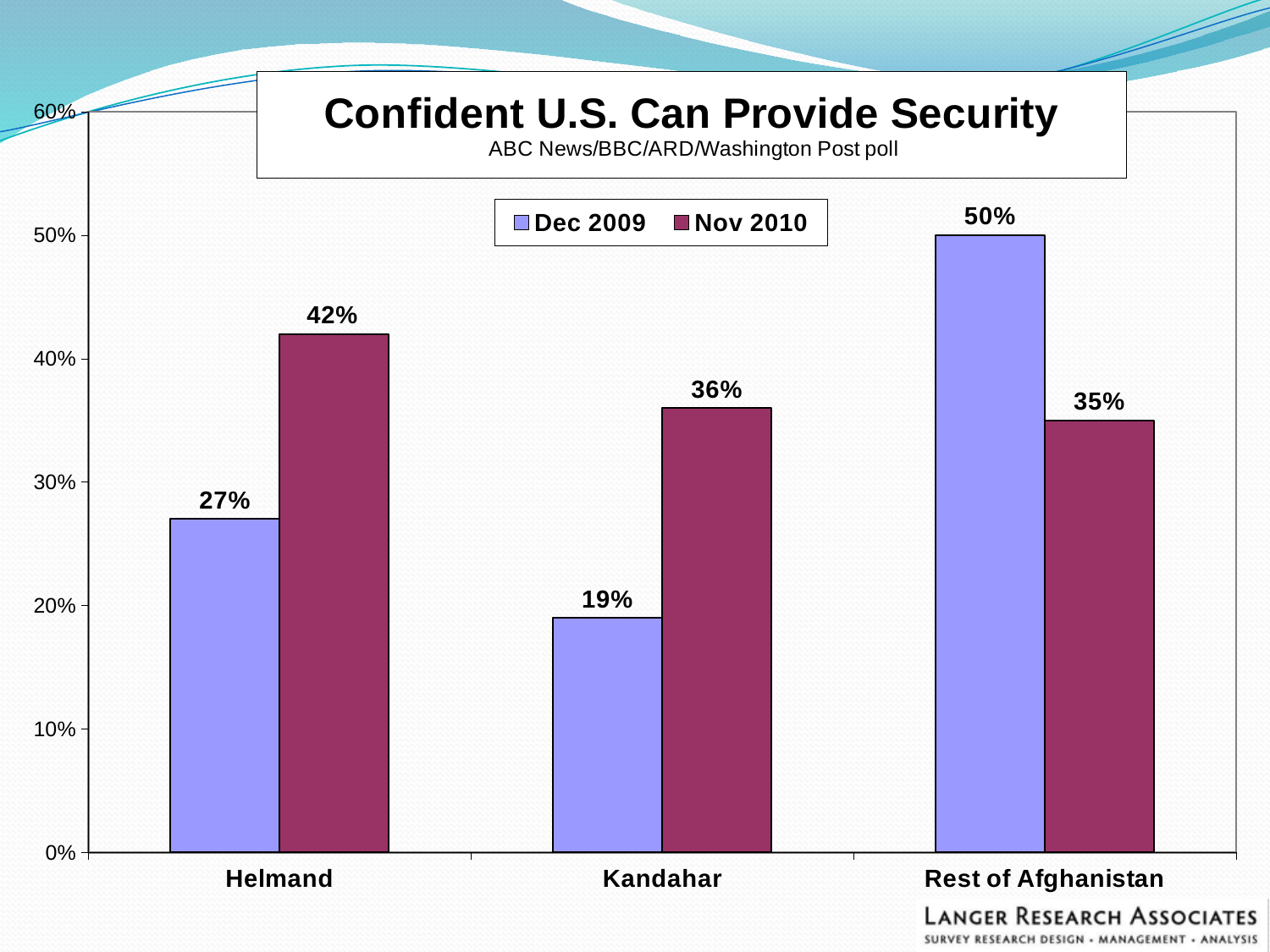
What is the title of the chart? Confident U.S. Can Provide Security Is the Nov 2010 value for Helmand greater or less than 40%? greater What is the Nov 2010 value for Kandahar? 36% How many series does the legend list? 2 Which category has the lowest Dec 2009 value? Kandahar How many categories are shown on the x axis? 3 What is the difference between the Nov 2010 and Dec 2009 values for Kandahar? 17% Which is larger for Rest of Afghanistan, the Dec 2009 value or the Nov 2010 value? Dec 2009 Which category has the highest Nov 2010 value? Helmand What is the Dec 2009 value for Rest of Afghanistan? 50% What kind of chart is shown on the slide? bar chart What is the Dec 2009 value for Helmand? 27%